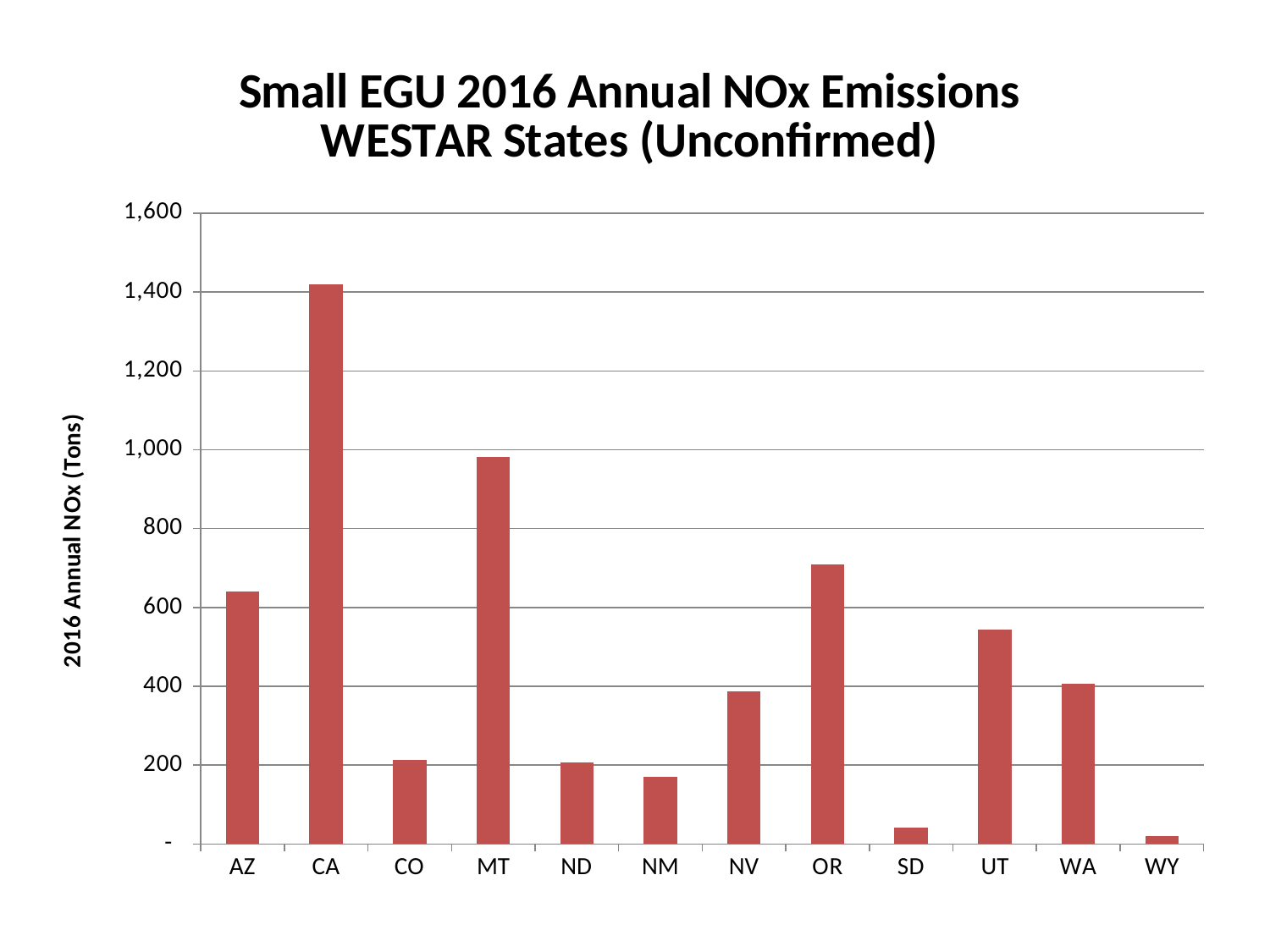
Which state has the lowest 2016 annual NOx emissions? WY Is the value for AZ greater or less than 600? greater How many states are shown on the x axis? 12 What kind of chart is shown on the slide? bar chart Which has higher NOx emissions, AZ or OR? OR Is the value for CA greater or less than 1,200? greater What is the label on the vertical axis? 2016 Annual NOx (Tons) Is the value for UT greater or less than 600? less Which has higher NOx emissions, UT or WA? UT Which state has the highest 2016 annual NOx emissions? CA